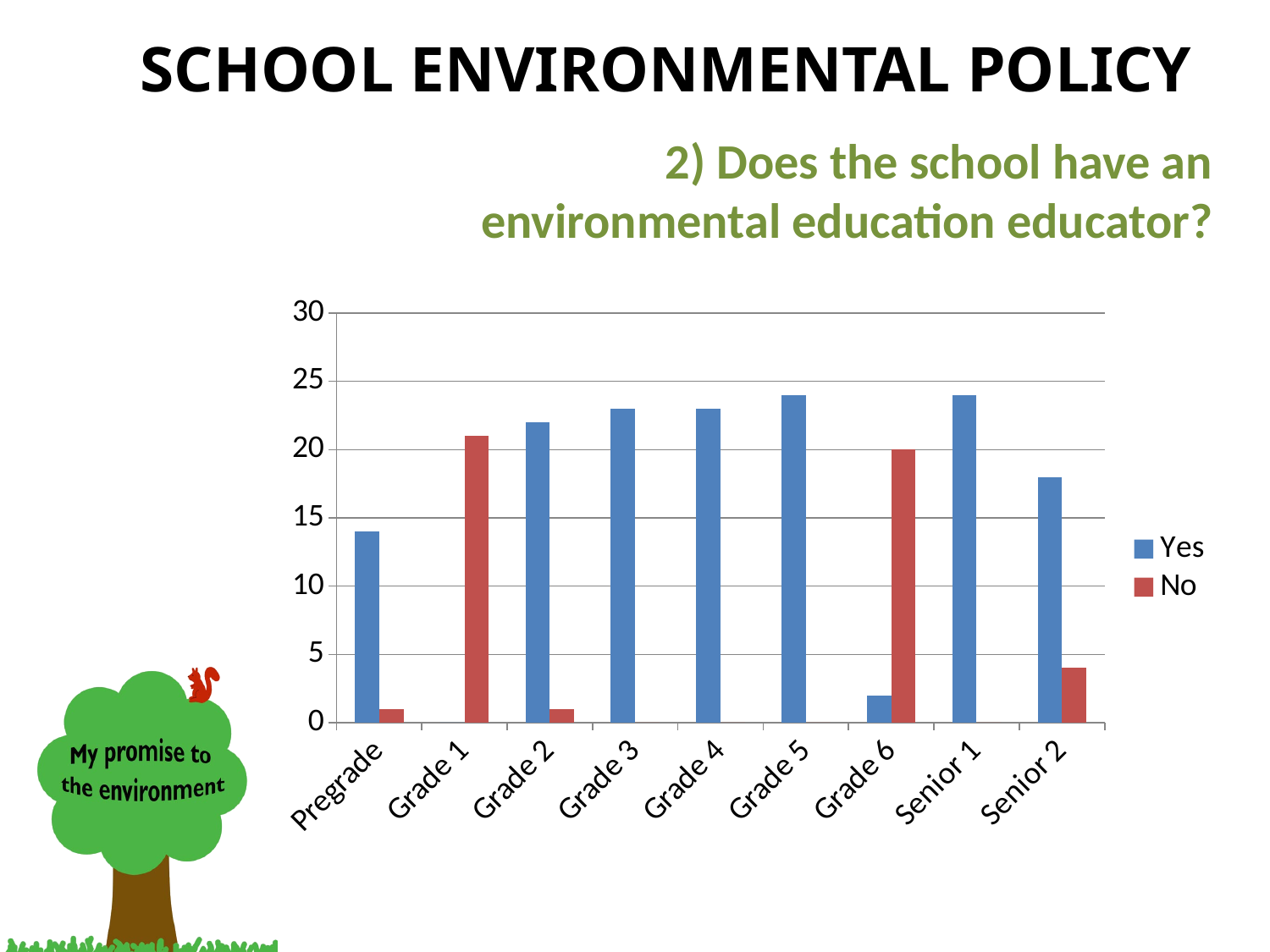
Which grade has the lowest Yes value? Grade 1 How many series does the chart's legend list? 2 What kind of chart is shown on the slide? bar chart Is the Yes value for Grade 6 greater or less than 5? less Is the Yes value for Senior 2 greater or less than 20? less Is the Yes value for Pregrade greater or less than 10? greater For Grade 6, which is larger, the Yes value or the No value? No Which series is shown in blue in the chart? Yes Which has the larger Yes value, Pregrade or Senior 2? Senior 2 How many grade categories are shown on the x axis of the chart? 9